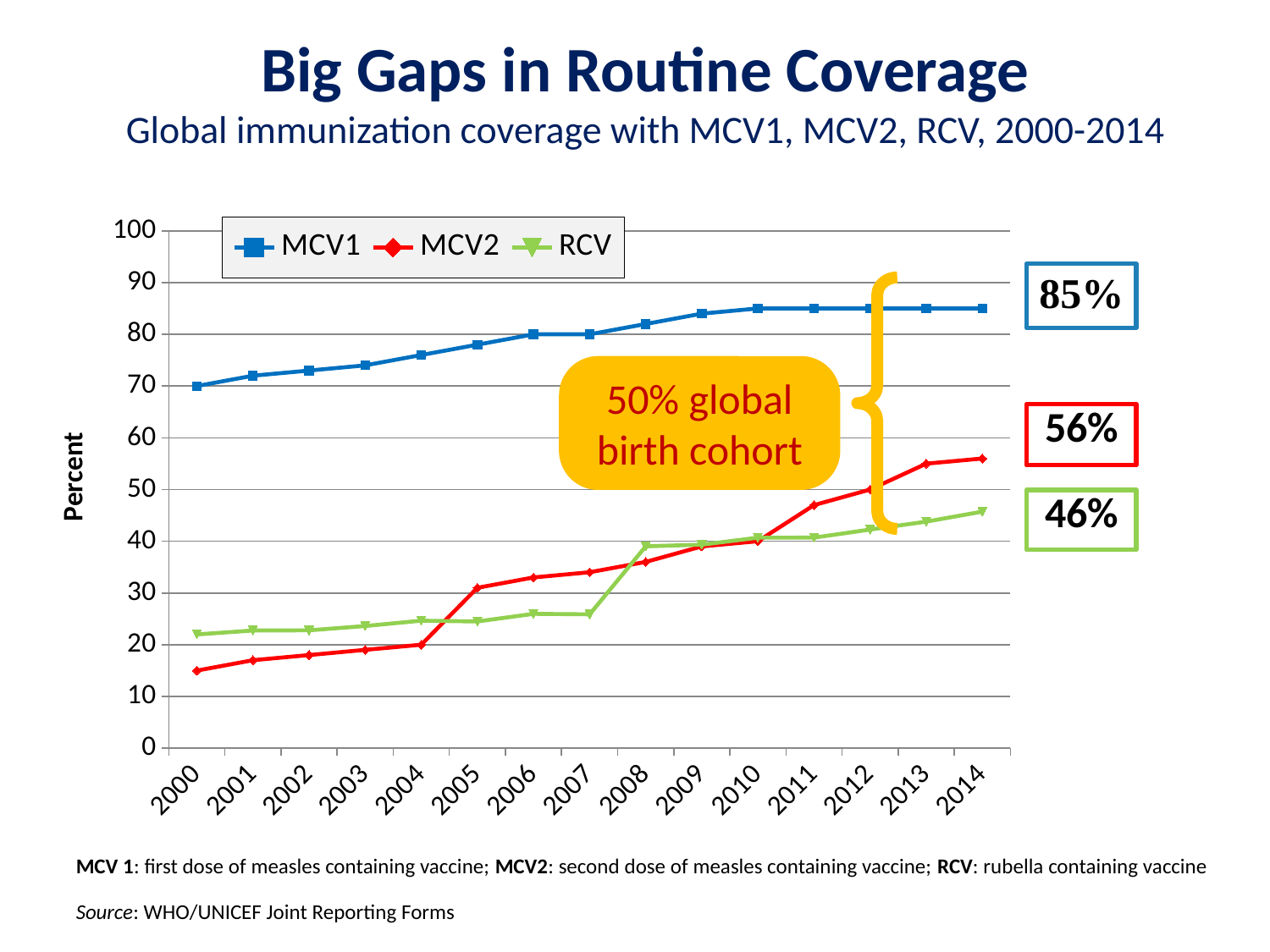
Does MCV1 coverage generally rise or fall from 2000 to 2014? rise How many years are plotted along the x axis? 15 What is the label on the y axis? Percent Is the MCV2 value for 2000 greater or less than 20? less Which series has the highest coverage in 2014? MCV1 What is the RCV coverage value shown for 2014? 46% In 2014, which is larger, MCV2 coverage or RCV coverage? MCV2 What is the MCV2 coverage value shown for 2014? 56% How many series does the legend list? 3 What is the difference between the MCV1 and MCV2 values shown for 2014? 29 percentage points What type of chart is shown on the slide? line chart What is the MCV1 coverage value shown for 2014? 85%